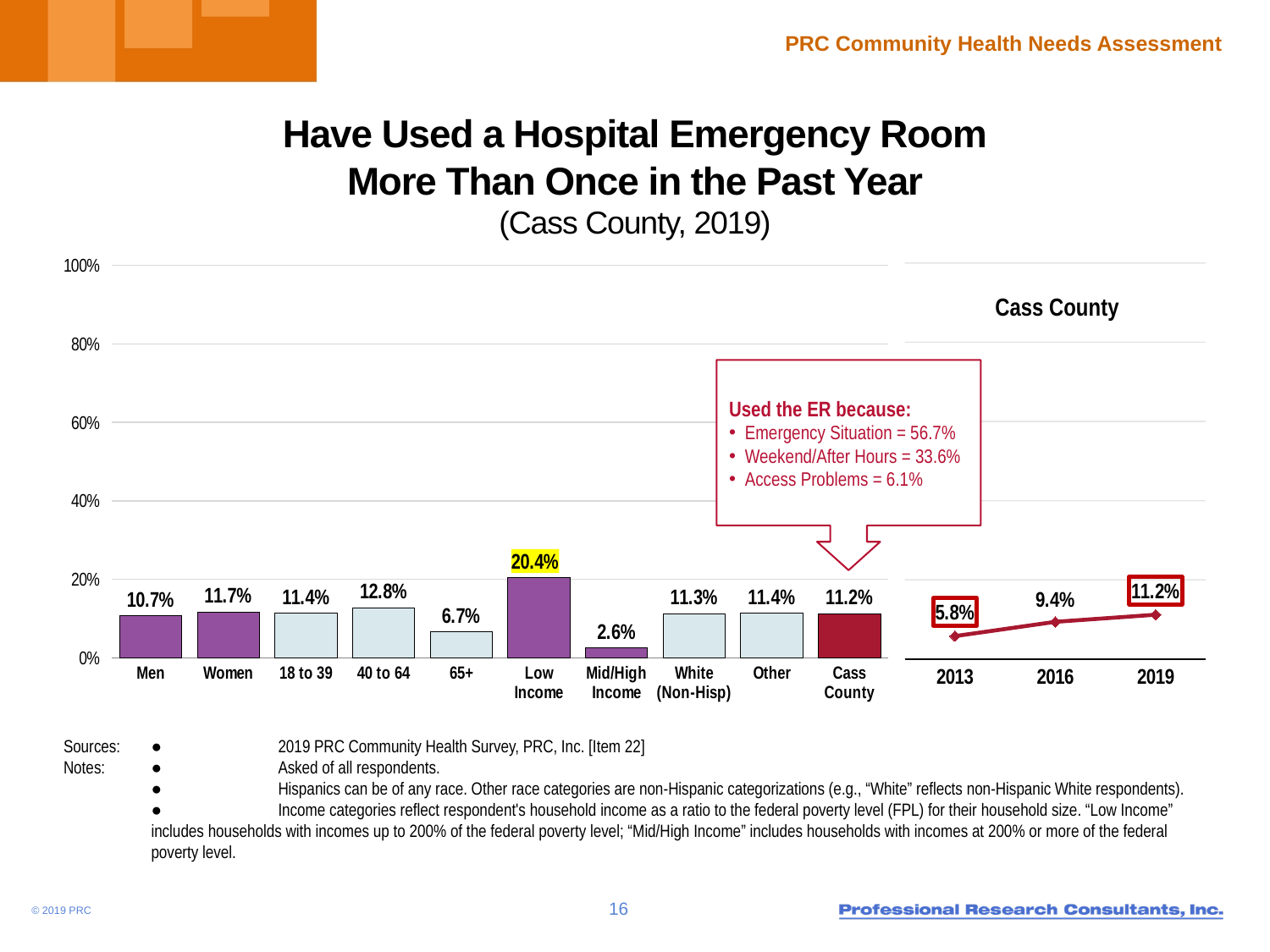
In the Cass County chart on the right, what is the difference between the 2019 and 2013 values? 5.4% In the bar chart on the left, which is larger, the value for Men or the value for 40 to 64? 40 to 64 In the bar chart on the left, what is the difference between the values for Low Income and Mid/High Income? 17.8% How many categories are shown in the bar chart on the left? 10 What kind of chart is the Cass County chart on the right? line chart In the Cass County chart on the right, what is the value for 2013? 5.8% In the bar chart on the left, what is the value for Women? 11.7% In the Cass County chart on the right, do the values rise or fall from 2013 to 2019? rise In the bar chart on the left, which category has the highest value? Low Income In the bar chart on the left, which category has the lowest value? Mid/High Income In the bar chart on the left, is the value for Low Income greater or less than 20%? greater In the bar chart on the left, what is the value for Low Income? 20.4%